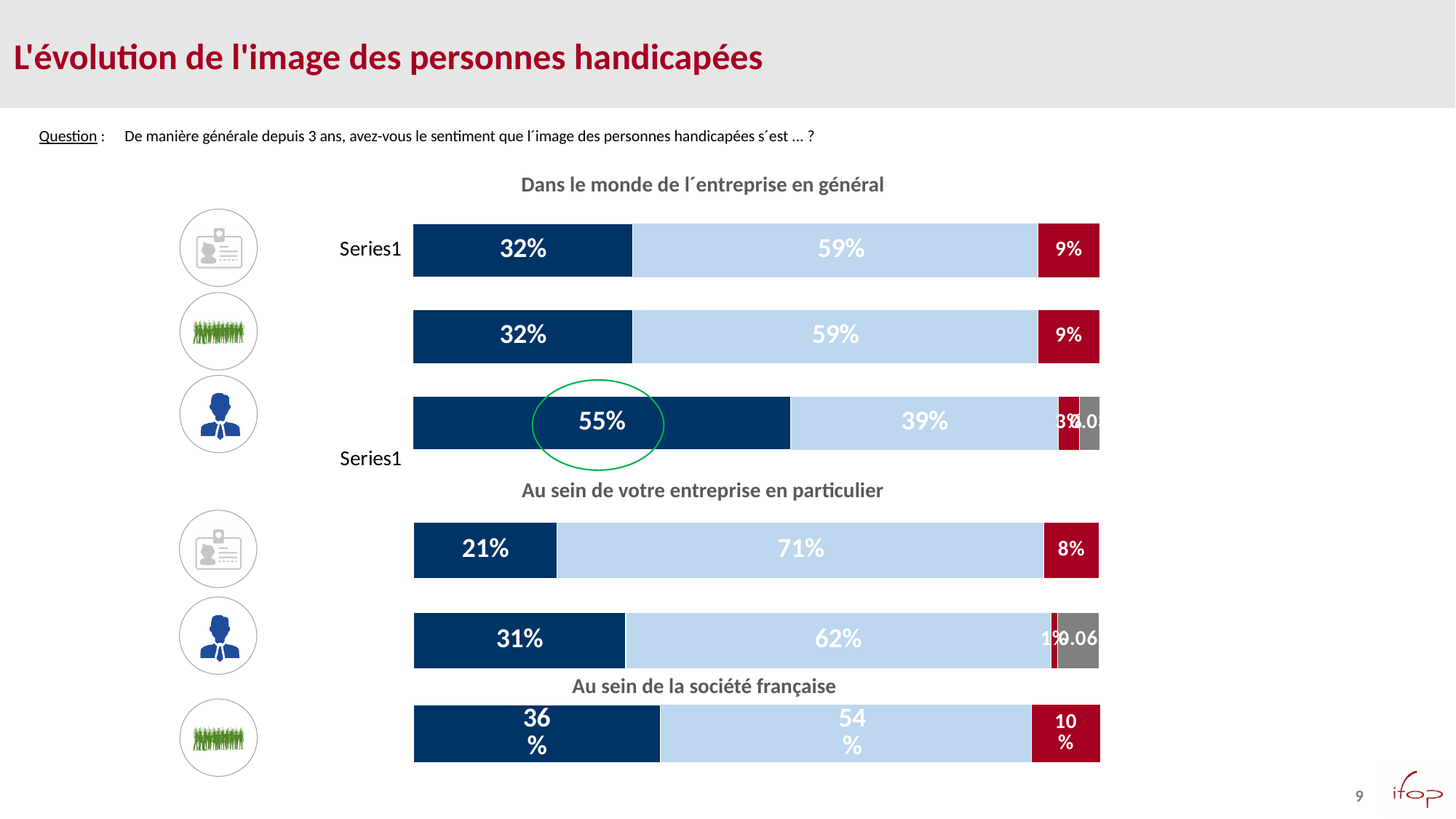
In the chart titled 'Au sein de la société française', which segment has the largest value? the light blue segment (54%) In the chart titled 'Au sein de la société française', what is the value of the red segment? 10% In the chart titled 'Dans le monde de l'entreprise en général', in the third bar, is the dark blue segment or the light blue segment larger? dark blue In the chart titled 'Dans le monde de l'entreprise en général', what is the value of the dark blue segment of the third bar? 55% In the chart titled 'Au sein de votre entreprise en particulier', what is the value of the dark blue segment of the second bar? 31% In the chart titled 'Dans le monde de l'entreprise en général', what is the value of the dark blue segment of the first (top) bar? 32% In the chart titled 'Dans le monde de l'entreprise en général', what is the difference between the light blue and dark blue segments of the first bar? 27 percentage points In the chart titled 'Au sein de votre entreprise en particulier', what is the difference between the light blue and dark blue segments of the first bar? 50 percentage points In the chart titled 'Au sein de votre entreprise en particulier', what is the value of the light blue segment of the first bar? 71% How many bars are shown under the title 'Dans le monde de l'entreprise en général'? 3 What kind of chart is used on this slide? bar chart Which value on the slide is circled in green? 55%